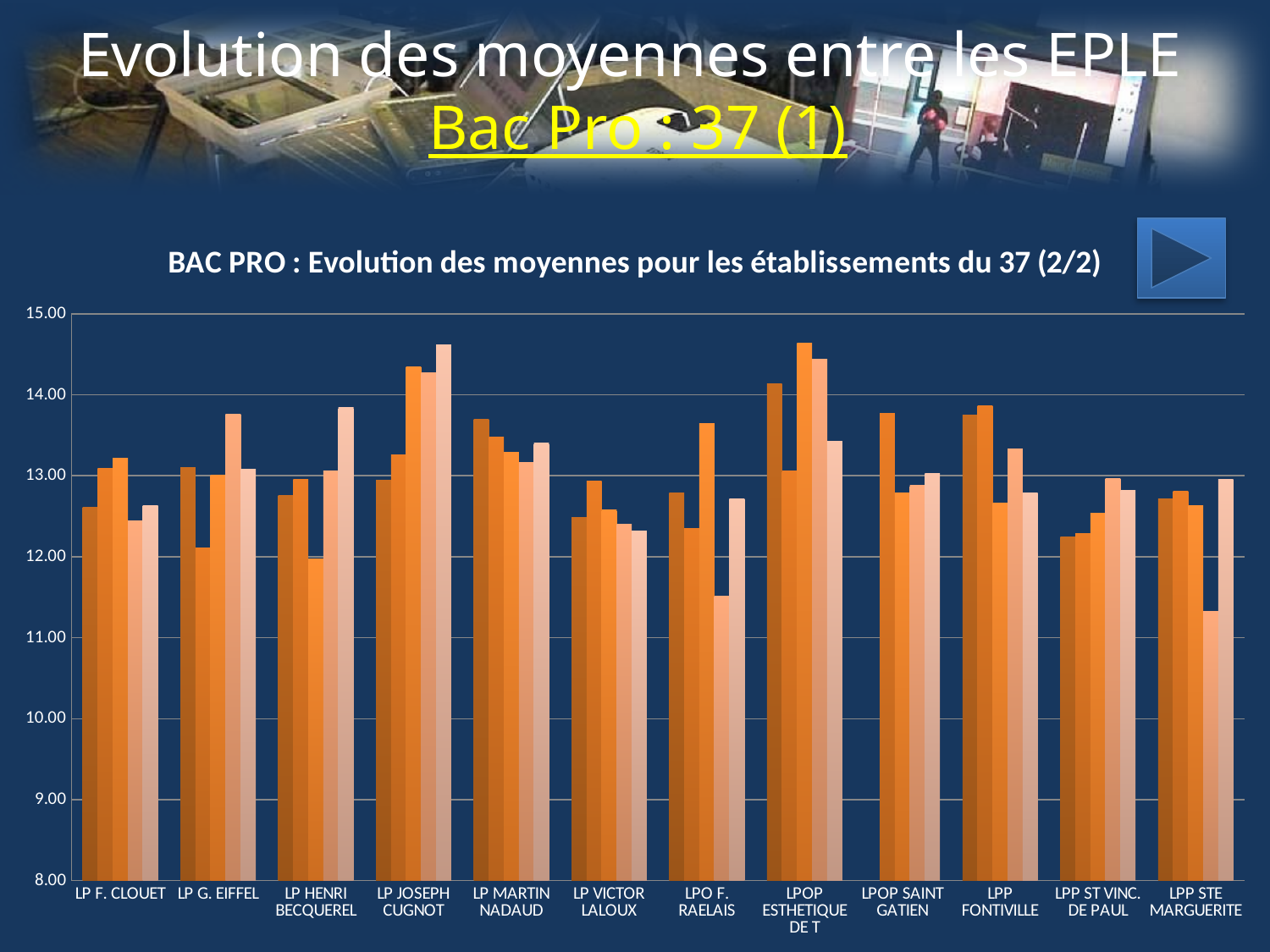
Is the value of the fourth bar for LPP STE MARGUERITE greater or less than 12.00? less Is the value of the second bar for LPOP ESTHETIQUE DE T greater or less than 14.00? less Is the value of the fourth bar for LPO F. RAELAIS greater or less than 12.00? less What is the highest value shown on the y axis of the chart? 15.00 What is the title of the chart? BAC PRO : Evolution des moyennes pour les établissements du 37 (2/2) What type of chart is shown on the slide? bar chart How many establishments (categories) are shown on the x axis of the chart? 12 How many bars are plotted for each establishment in the chart? 5